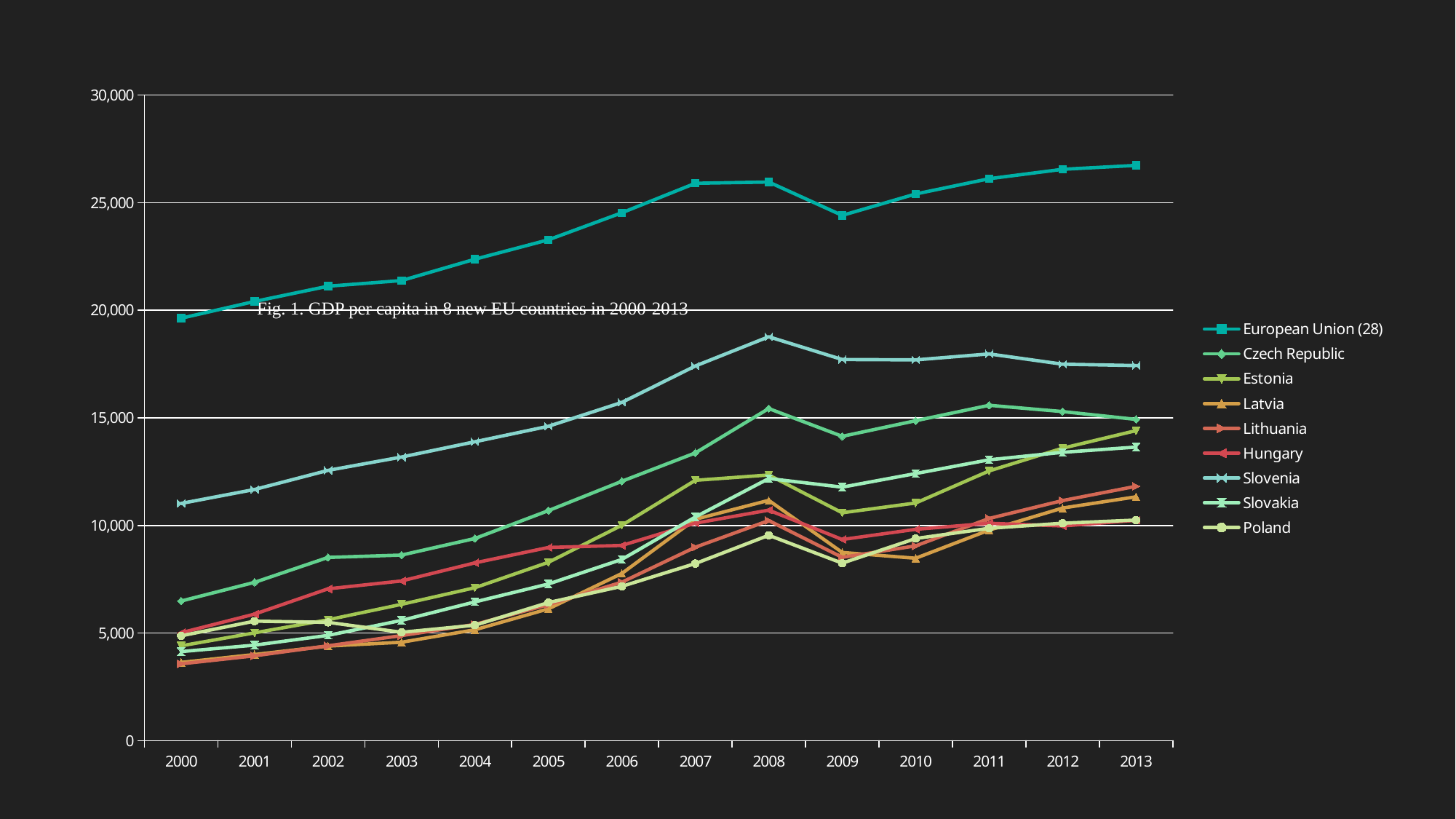
Does the European Union (28) series generally rise or fall from 2000 to 2013? rise How many series does the legend list? 9 What kind of chart is shown on the slide? line chart Is the value for Slovenia in 2008 greater or less than 20,000? less Is the value for Hungary in 2005 greater or less than 10,000? less Is the value for Czech Republic in 2000 greater or less than 5,000? greater How many years are shown along the x axis? 14 Which is larger in 2013, the value for Slovenia or the value for Czech Republic? Slovenia What is the title of the chart? Fig. 1. GDP per capita in 8 new EU countries in 2000-2013 Which series has the highest value in 2000? European Union (28) Which series has the highest value in 2013? European Union (28)